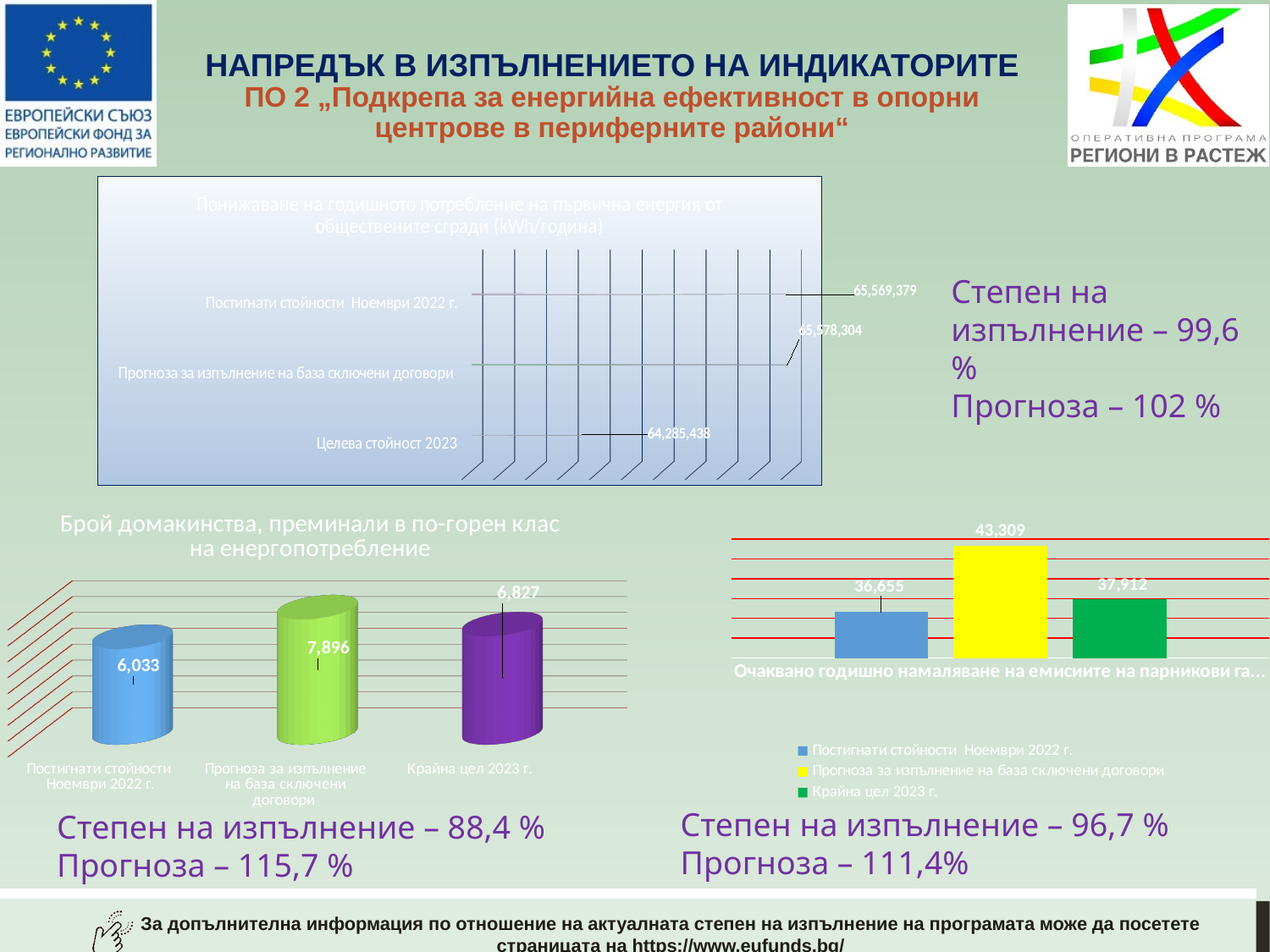
In the bottom-left chart 'Брой домакинства, преминали в по-горен клас на енергопотребление', what is the value for 'Прогноза за изпълнение на база сключени договори'? 7,896 In the bottom-left chart 'Брой домакинства, преминали в по-горен клас на енергопотребление', which category has the lowest value? Постигнати стойности Ноември 2022 г. In the top chart 'Понижаване на годишното потребление на първична енергия от обществените сгради (kWh/година)', what is the value for 'Целева стойност 2023'? 64,285,438 In the bottom-left chart 'Брой домакинства, преминали в по-горен клас на енергопотребление', what is the difference between 'Прогноза за изпълнение на база сключени договори' and 'Постигнати стойности Ноември 2022 г.'? 1,863 In the bottom-right chart 'Очаквано годишно намаляване на емисиите на парникови га...', what is the value for 'Крайна цел 2023 г.'? 37,912 In the bottom-right chart 'Очаквано годишно намаляване на емисиите на парникови га...', what is the difference between 'Прогноза за изпълнение на база сключени договори' and 'Постигнати стойности Ноември 2022 г.'? 6,654 What kind of chart is the top chart 'Понижаване на годишното потребление на първична енергия от обществените сгради (kWh/година)'? Bar chart In the bottom-right chart 'Очаквано годишно намаляване на емисиите на парникови га...', how many series does the legend list? 3 In the bottom-right chart 'Очаквано годишно намаляване на емисиите на парникови га...', which colour represents 'Крайна цел 2023 г.'? Green In the bottom-left chart 'Брой домакинства, преминали в по-горен клас на енергопотребление', how many bars are shown? 3 In the top chart 'Понижаване на годишното потребление на първична енергия от обществените сгради (kWh/година)', what is the value for 'Постигнати стойности Ноември 2022 г.'? 65,569,379 In the bottom-right chart 'Очаквано годишно намаляване на емисиите на парникови га...', which series has the highest value? Прогноза за изпълнение на база сключени договори